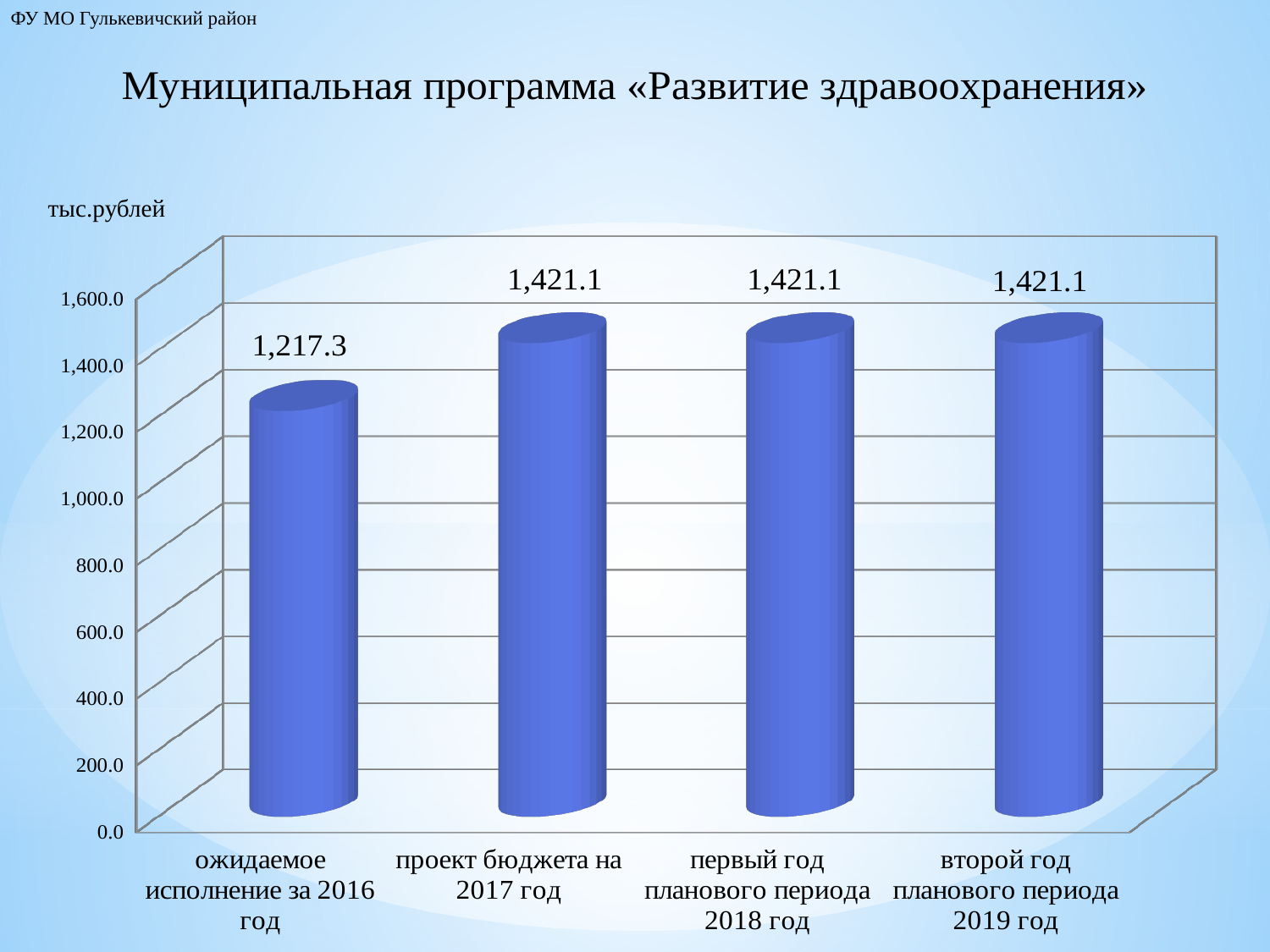
Does the value rise or fall from 'ожидаемое исполнение за 2016 год' to 'проект бюджета на 2017 год'? rise Which category has the lowest value? ожидаемое исполнение за 2016 год Is the value for 'ожидаемое исполнение за 2016 год' greater or less than 1,400.0? less What kind of chart is shown on the slide? bar chart What is the value for 'проект бюджета на 2017 год'? 1,421.1 What is the value for 'ожидаемое исполнение за 2016 год'? 1,217.3 What is the difference between the value for 2017 (проект бюджета) and the value for 2016 (ожидаемое исполнение)? 203.8 What is the value for 'первый год планового периода 2018 год'? 1,421.1 How many categories are shown on the x axis? 4 Which is larger: the value for 'проект бюджета на 2017 год' or the value for 'ожидаемое исполнение за 2016 год'? проект бюджета на 2017 год What is the value for 'второй год планового периода 2019 год'? 1,421.1 What unit is indicated above the chart's vertical axis? тыс.рублей